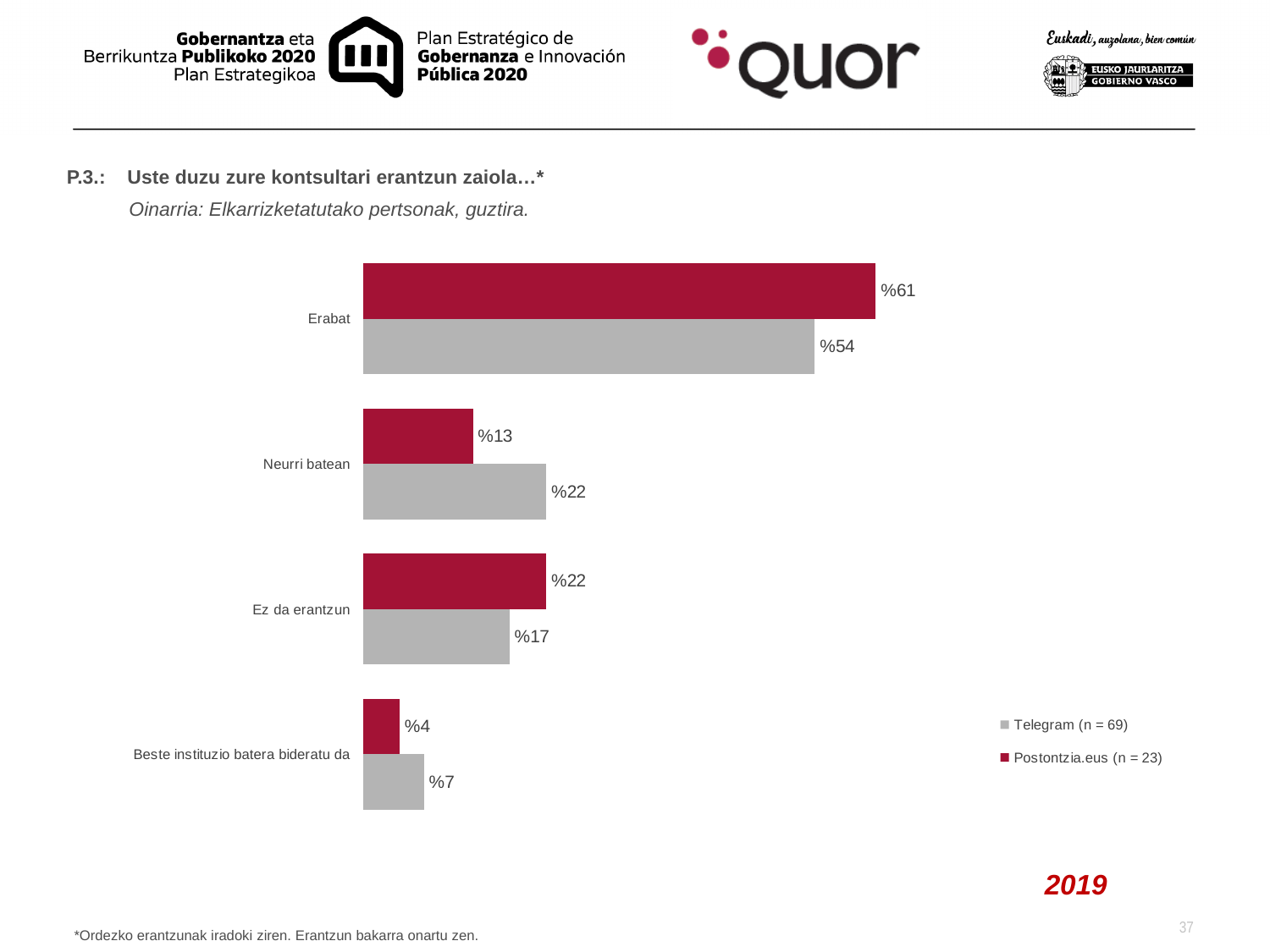
How many series does the legend list? 2 Which category has the highest value in the Telegram (n = 69) series? Erabat What is the value for Erabat in the Postontzia.eus (n = 23) series? %61 What is the value for Erabat in the Telegram (n = 69) series? %54 For Ez da erantzun, which series has the larger value, Telegram or Postontzia.eus? Postontzia.eus What is the difference between the Postontzia.eus and Telegram values for Erabat? %7 What kind of chart is shown on the slide? Bar chart Which category has the lowest value in the Postontzia.eus (n = 23) series? Beste instituzio batera bideratu da For Neurri batean, which series has the larger value, Telegram or Postontzia.eus? Telegram What is the value for Neurri batean in the Telegram (n = 69) series? %22 What is the value for Beste instituzio batera bideratu da in the Postontzia.eus (n = 23) series? %4 How many categories are shown on the chart? 4